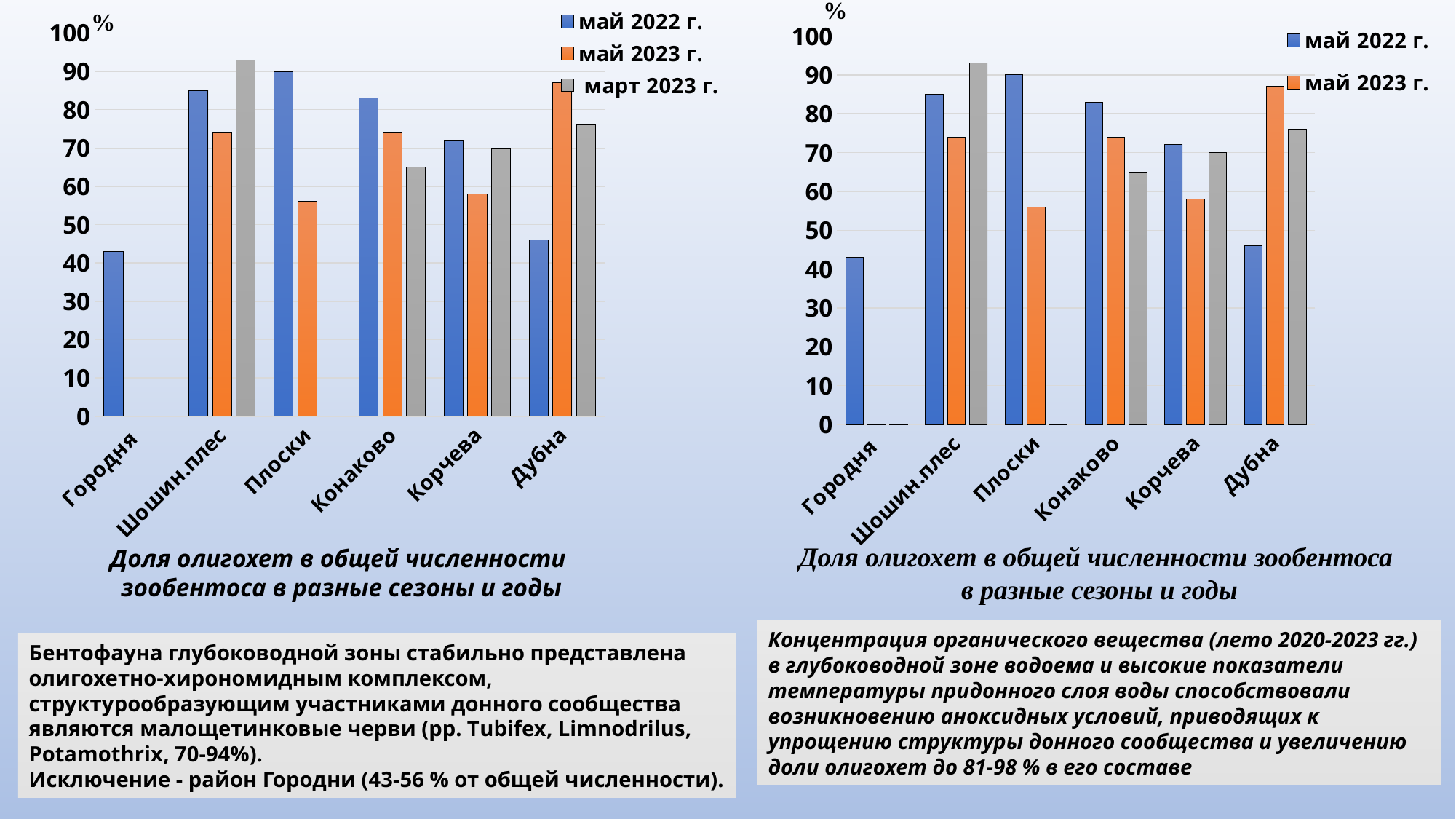
In the left chart, which series is shown in grey according to the legend? март 2023 г. In the left chart, which is larger for Шошин.плес: the май 2022 г. value or the май 2023 г. value? май 2022 г. In the left chart, which category has the highest value for май 2023 г.? Дубна How many categories are shown on the x axis of the left chart? 6 How many series does the legend of the left chart list? 3 In the left chart, is the май 2022 г. value for Городня greater or less than 50? less In the left chart, is the май 2023 г. value for Плоски greater or less than 60? less In the right chart, is the май 2023 г. value for Дубна greater or less than 80? greater In the left chart, which category has the highest value for май 2022 г.? Плоски What kind of chart is the left chart? bar chart How many series does the legend of the right chart list? 2 In the right chart, which is larger for Дубна: the май 2022 г. value or the май 2023 г. value? май 2023 г.